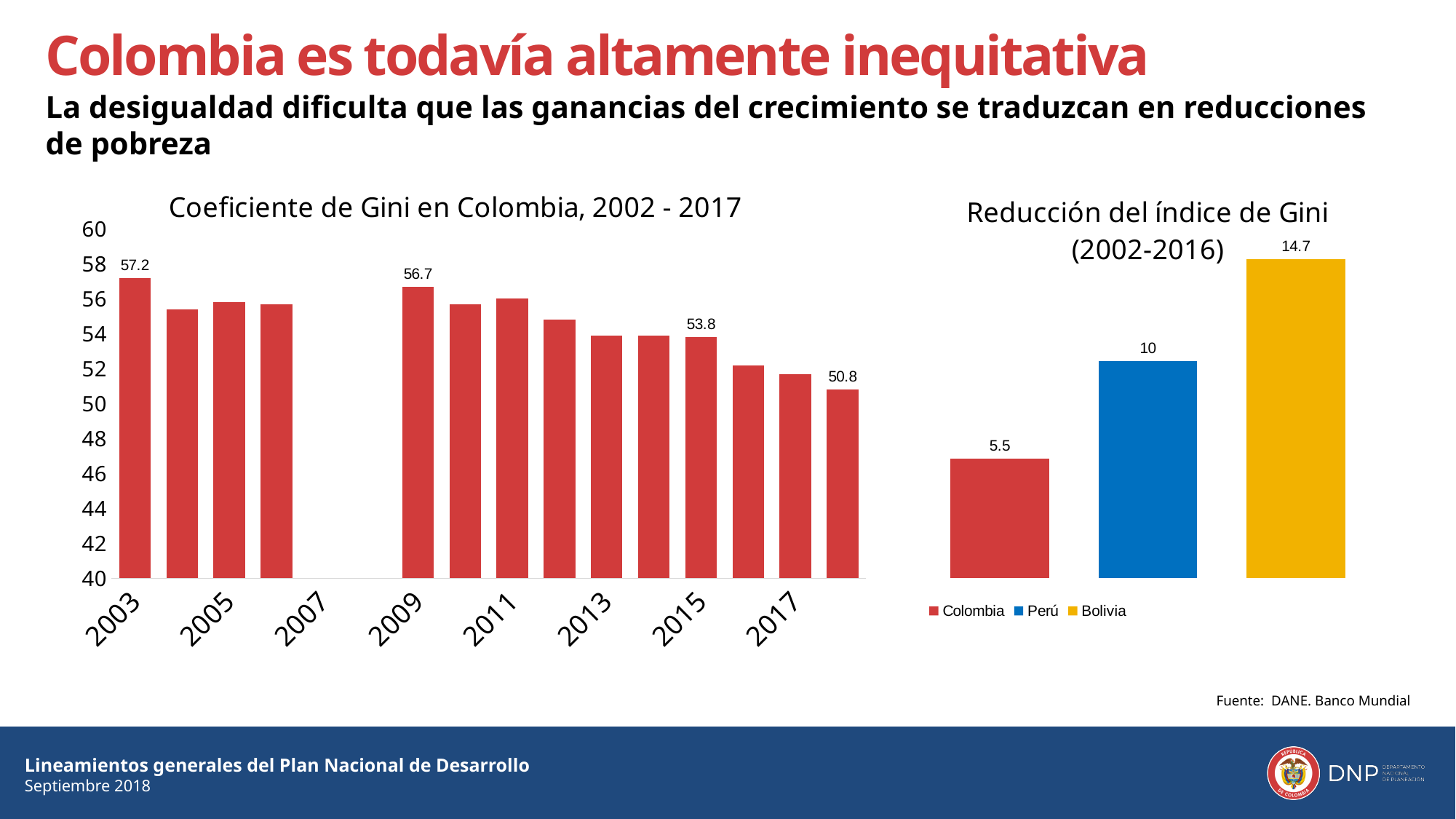
In the chart 'Coeficiente de Gini en Colombia, 2002 - 2017', do the values generally rise or fall over time? Fall In the chart 'Reducción del índice de Gini (2002-2016)', which country has the highest value? Bolivia What kind of chart is 'Coeficiente de Gini en Colombia, 2002 - 2017'? Bar chart In the chart 'Reducción del índice de Gini (2002-2016)', what colour is the bar for Bolivia? Yellow How many entries does the legend of the chart 'Reducción del índice de Gini (2002-2016)' list? 3 In the chart 'Reducción del índice de Gini (2002-2016)', which is larger, the value for Perú or the value for Colombia? Perú In the chart 'Reducción del índice de Gini (2002-2016)', which country has the lowest value? Colombia In the chart 'Reducción del índice de Gini (2002-2016)', what is the difference between the values for Bolivia and Colombia? 9.2 In the chart 'Reducción del índice de Gini (2002-2016)', what is the value for Bolivia? 14.7 In the chart 'Coeficiente de Gini en Colombia, 2002 - 2017', what value is labelled on the last bar (2017)? 50.8 In the chart 'Reducción del índice de Gini (2002-2016)', what is the value for Colombia? 5.5 In the chart 'Coeficiente de Gini en Colombia, 2002 - 2017', what value is labelled on the first bar? 57.2